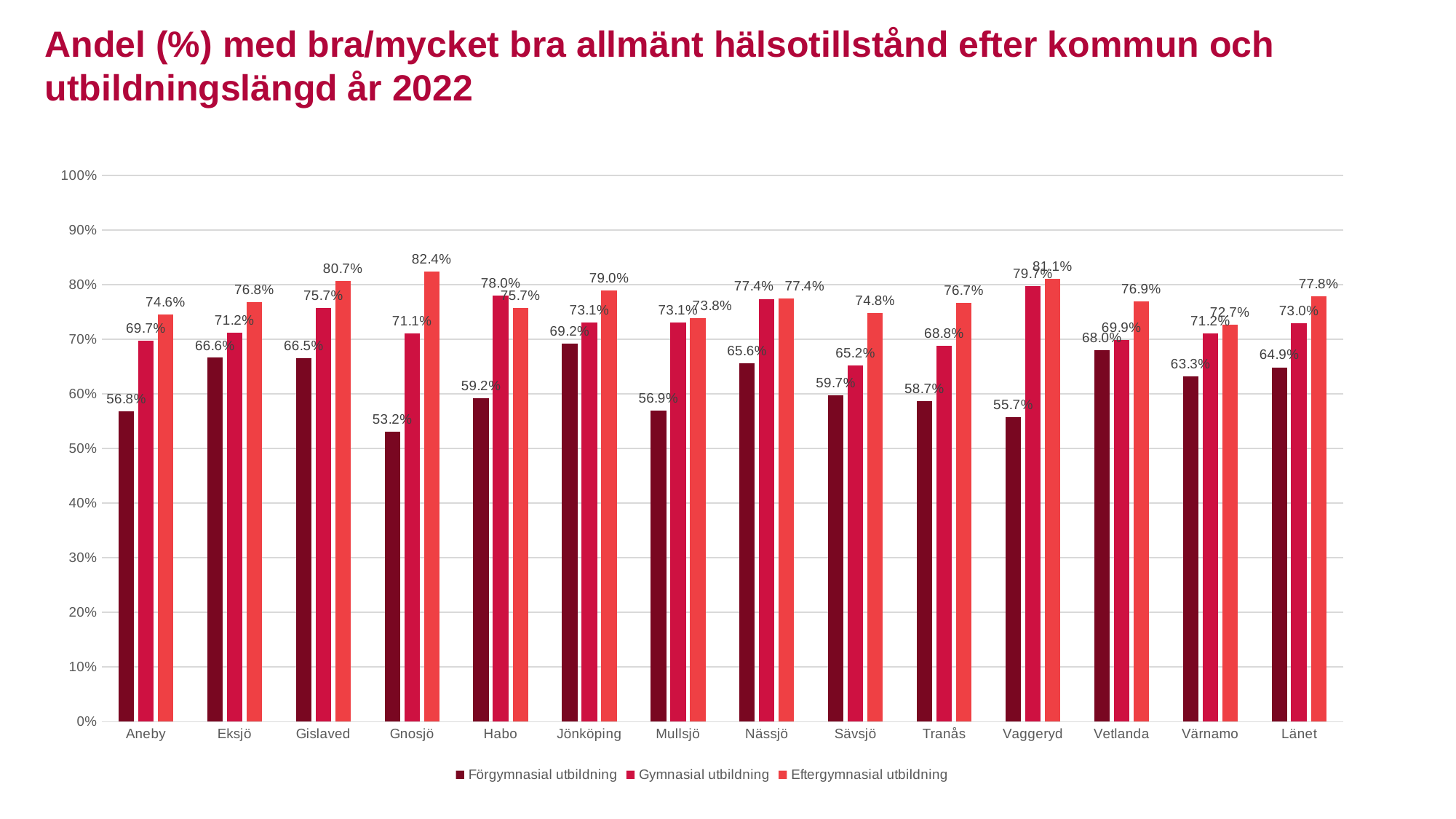
In Habo, which is larger: Gymnasial utbildning or Eftergymnasial utbildning? Gymnasial utbildning Which category has the lowest value for Förgymnasial utbildning? Gnosjö Is the value for Förgymnasial utbildning in Vaggeryd greater or less than 60%? less Which municipality has the highest value for Eftergymnasial utbildning? Gnosjö How many categories are shown on the x axis? 14 What is the difference between Eftergymnasial utbildning and Förgymnasial utbildning in Gnosjö? 29.2 percentage points What is the value for Förgymnasial utbildning in Gnosjö? 53.2% What kind of chart is shown on the slide? Bar chart What is the value for Eftergymnasial utbildning in Vaggeryd? 81.1% Which category has the highest value for Förgymnasial utbildning? Jönköping How many series does the legend list? 3 What is the value for Gymnasial utbildning in Länet? 73.0%